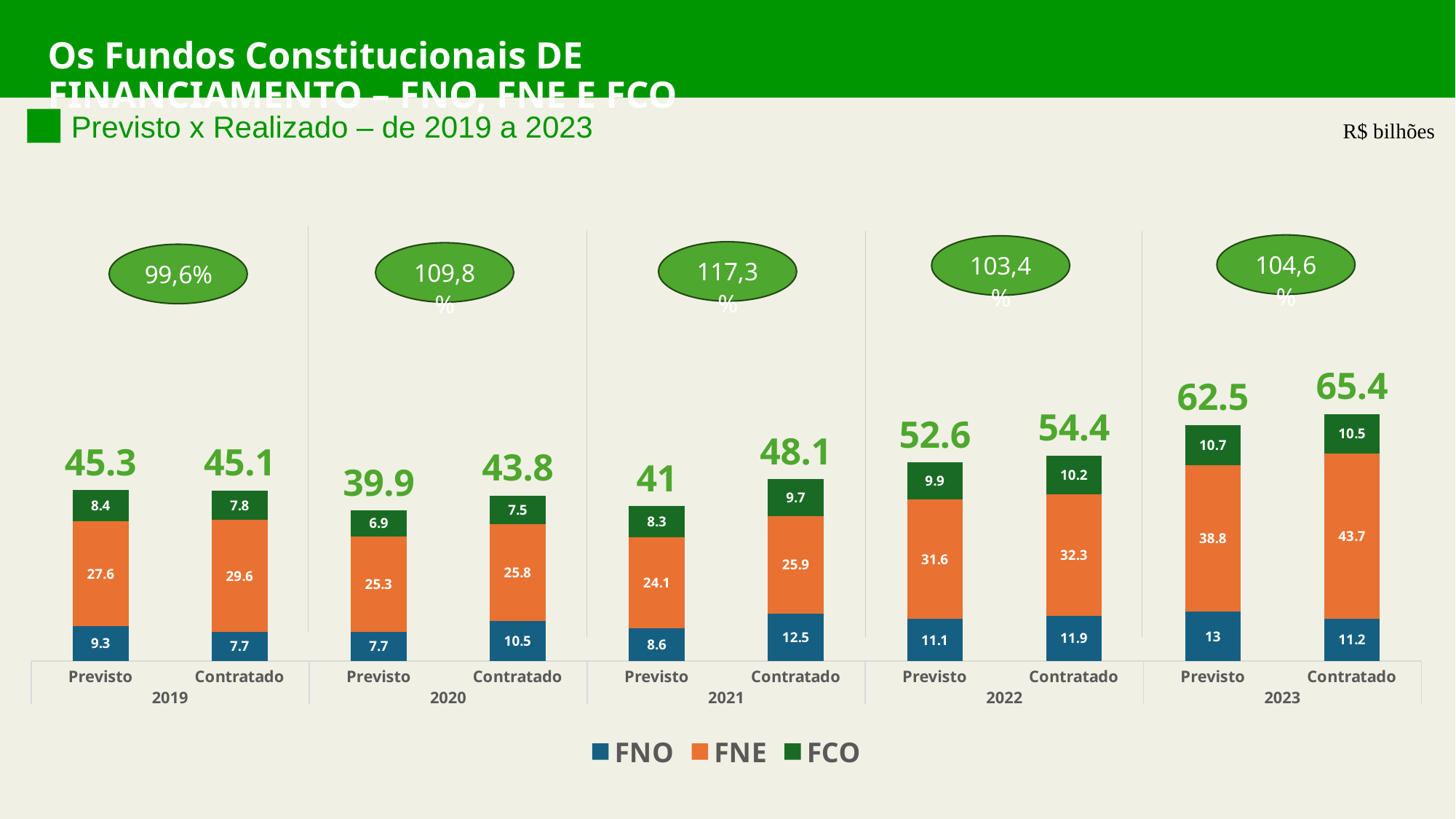
What is the difference between the Contratado and Previsto totals in 2021? 7.1 How many series does the legend list? 3 What is the FNE value for Contratado in 2023? 43.7 Do the Previsto totals rise or fall from 2020 to 2023? Rise Which bar has the lowest total value? Previsto 2020 Which bar has the highest total value? Contratado 2023 Which is larger, the FCO value for Previsto 2023 or for Contratado 2023? Previsto 2023 What percentage is shown in the oval above the 2021 bars? 117,3% What kind of chart is shown on the slide? Stacked bar chart How many bars are plotted in the chart? 10 What is the FNO value for Previsto in 2021? 8.6 What is the total of the Contratado bar for 2022? 54.4